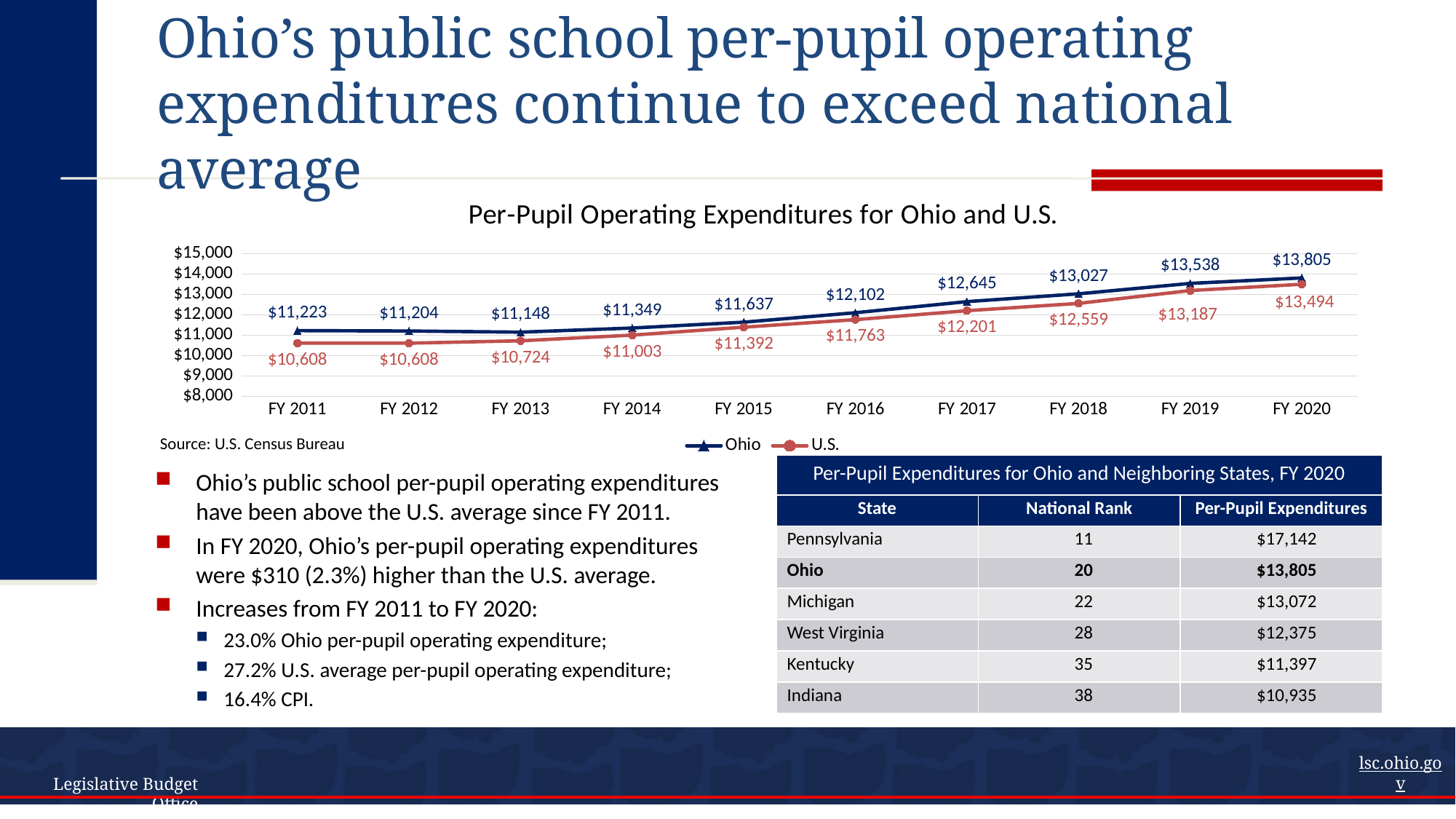
Is the U.S. per-pupil operating expenditure for FY 2014 greater or less than $12,000? less In which fiscal year is the U.S. per-pupil operating expenditure highest? FY 2020 What is the U.S. per-pupil operating expenditure for FY 2015? $11,392 In which fiscal year is the Ohio per-pupil operating expenditure lowest? FY 2013 How many series does the chart's legend list? 2 What type of chart is used to show per-pupil operating expenditures for Ohio and U.S.? Line chart Which is larger in FY 2016, the Ohio or the U.S. per-pupil operating expenditure? Ohio What is the Ohio per-pupil operating expenditure for FY 2013? $11,148 What is the Ohio per-pupil operating expenditure for FY 2020? $13,805 By how much did Ohio's per-pupil operating expenditure increase from FY 2011 to FY 2020? $2,582 What is the difference between the Ohio and U.S. per-pupil operating expenditures in FY 2011? $615 How many fiscal years are shown on the x axis of the chart? 10